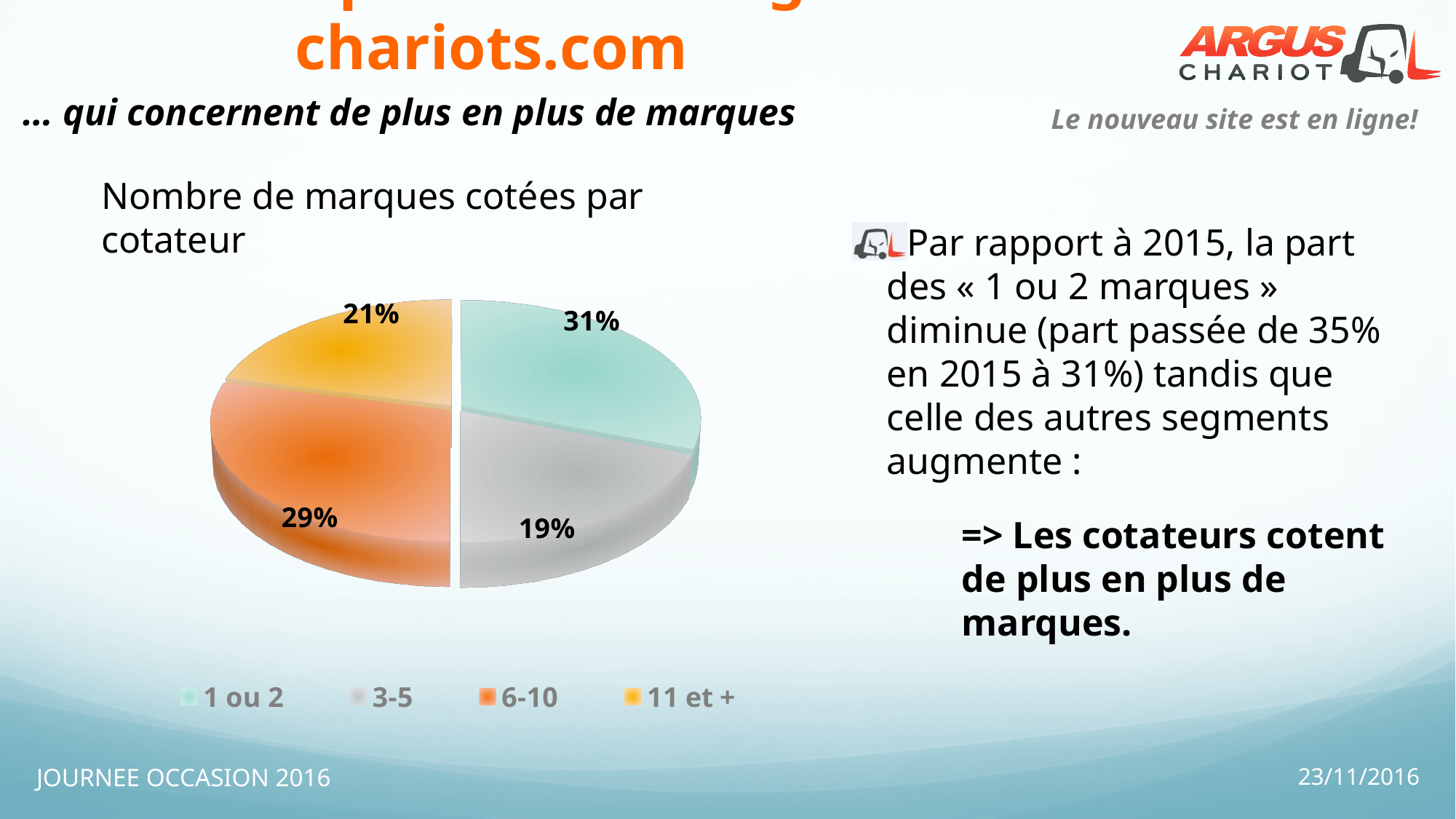
Which category has the smallest slice of the pie? 3-5 What share of the pie does the "6-10" slice represent? 29% Which slice is larger, "6-10" or "11 et +"? 6-10 What share of the pie does the "1 ou 2" slice represent? 31% What is the difference in percentage points between the "1 ou 2" slice and the "3-5" slice? 12 What share of the pie does the "3-5" slice represent? 19% Which colour represents the "6-10" category in the legend? orange What is the title of the chart? Nombre de marques cotées par cotateur Which category has the largest slice of the pie? 1 ou 2 How many categories does the pie chart show? 4 What type of chart is shown on the slide? pie chart What share of the pie does the "11 et +" slice represent? 21%